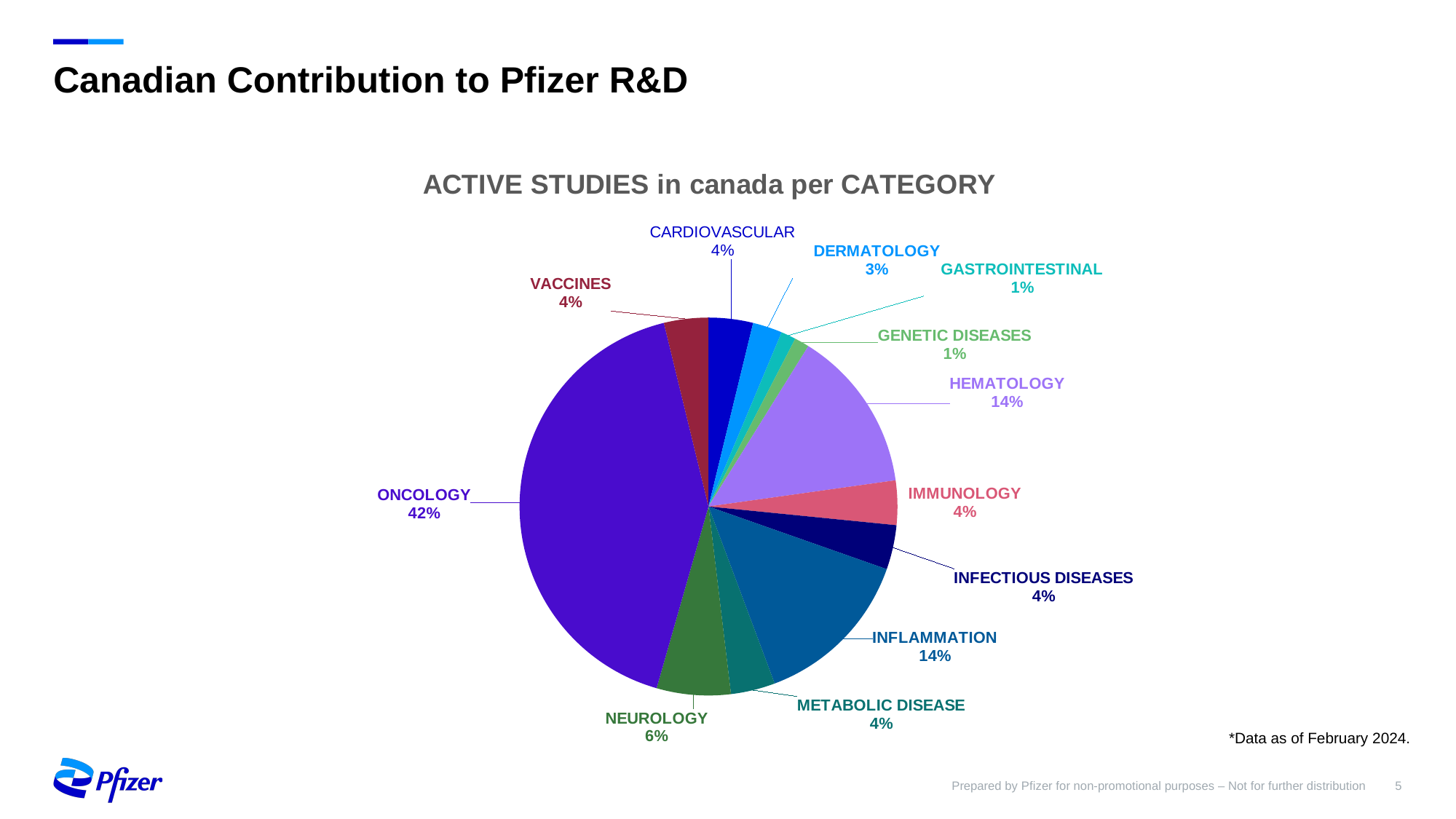
What is the combined share of Hematology and Inflammation? 28% What kind of chart is shown on the slide? pie chart What percentage is shown for Neurology? 6% Which is larger, the share for Neurology or the share for Vaccines? Neurology What is the difference in percentage points between Oncology and Inflammation? 28 What is the title of the chart? ACTIVE STUDIES in canada per CATEGORY What percentage is shown for Gastrointestinal? 1% What percentage is shown for Dermatology? 3% What share of active studies is in Oncology? 42% What percentage is shown for Hematology? 14% How many categories are shown in the pie chart? 12 Which category has the largest share of the pie? Oncology